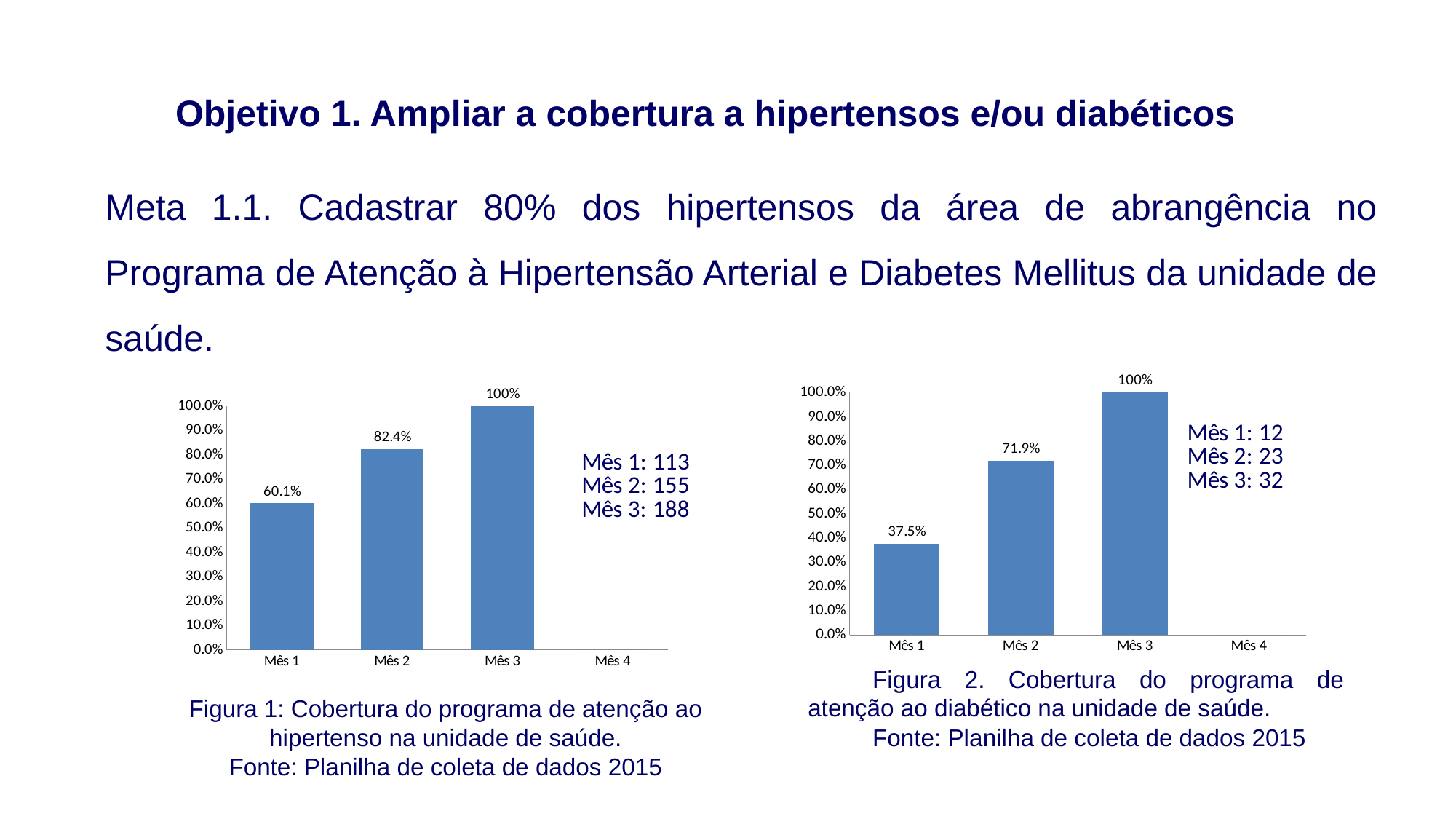
In the right chart (Figura 2), do the values rise or fall from Mês 1 to Mês 3? rise In the left chart (Figura 1), what is the value for Mês 2? 82.4% In the right chart (Figura 2), what is the value for Mês 2? 71.9% In the left chart (Figura 1), how many bars are plotted? 3 In the right chart (Figura 2), what is the difference between the values for Mês 3 and Mês 2? 28.1 percentage points Which is larger: the value for Mês 1 in the left chart (Figura 1) or the value for Mês 1 in the right chart (Figura 2)? Mês 1 in the left chart (Figura 1) In the left chart (Figura 1), what is the value for Mês 1? 60.1% In the left chart (Figura 1), which month has the highest value? Mês 3 What kind of chart is the left chart (Figura 1)? bar chart In the left chart (Figura 1), what is the difference between the values for Mês 2 and Mês 1? 22.3 percentage points In the right chart (Figura 2), which month with a plotted bar has the lowest value? Mês 1 In the right chart (Figura 2), what is the value for Mês 1? 37.5%